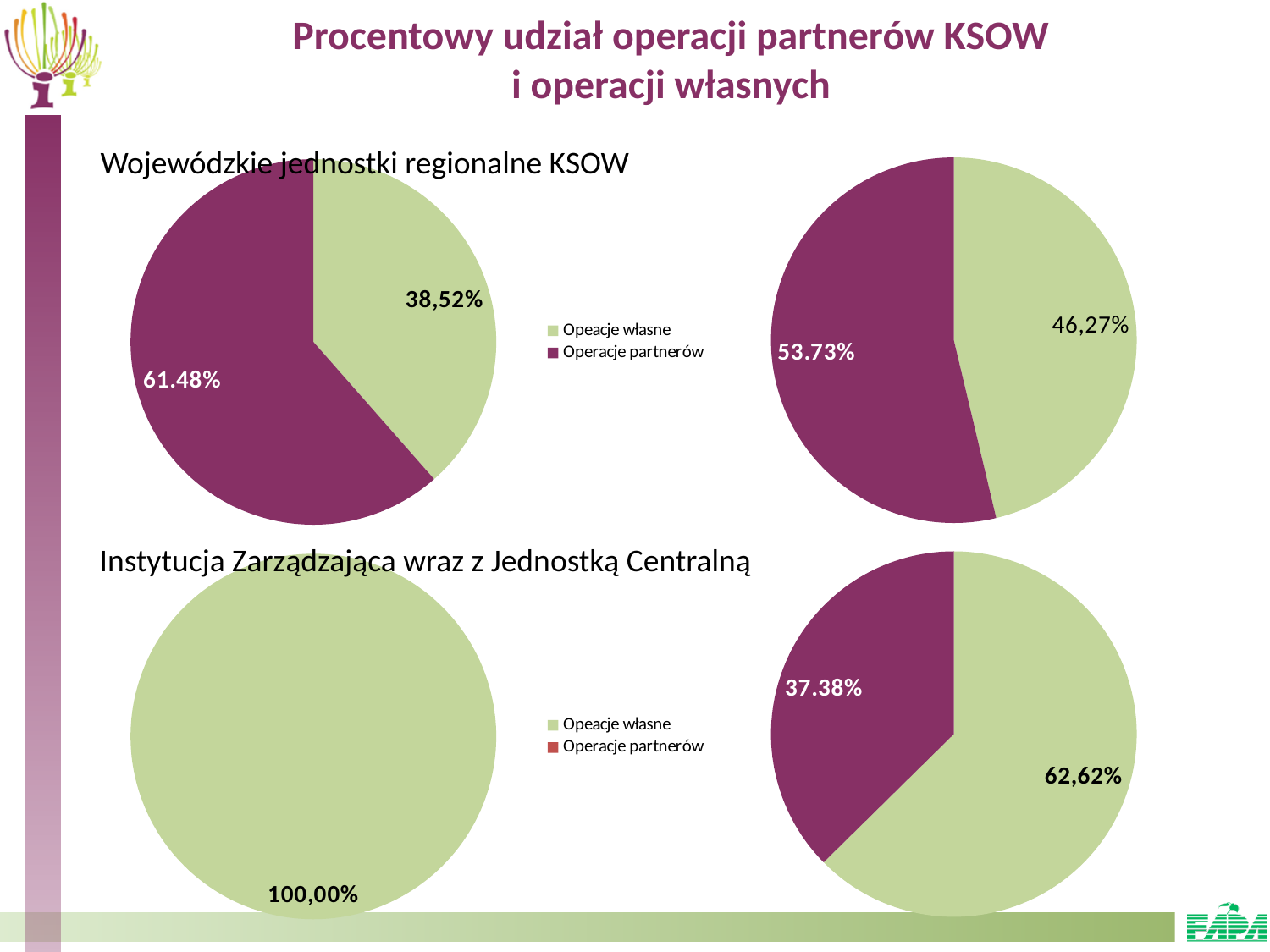
In the bottom-right pie chart, which category has the smaller share? Operacje partnerów In the top-right pie chart, is the share for Operacje partnerów larger or smaller than the share for Opeacje własne? larger In the top-right pie chart, what is the share of the purple slice (Operacje partnerów)? 53.73% In the top-left pie chart, what is the share for Operacje partnerów? 61.48% In the top-left pie chart, what is the share for Opeacje własne? 38,52% In the top-right pie chart, what is the share of the green slice (Opeacje własne)? 46,27% In the bottom-right pie chart, what is the share for Opeacje własne? 62,62% How many pie charts are shown on the slide? 4 How many entries does the legend next to the top-left pie chart list? 2 In the bottom-right pie chart, what is the share for Operacje partnerów? 37.38% In the bottom-left pie chart, what share is shown for the single slice? 100,00% In the top-left pie chart, which category has the larger share? Operacje partnerów